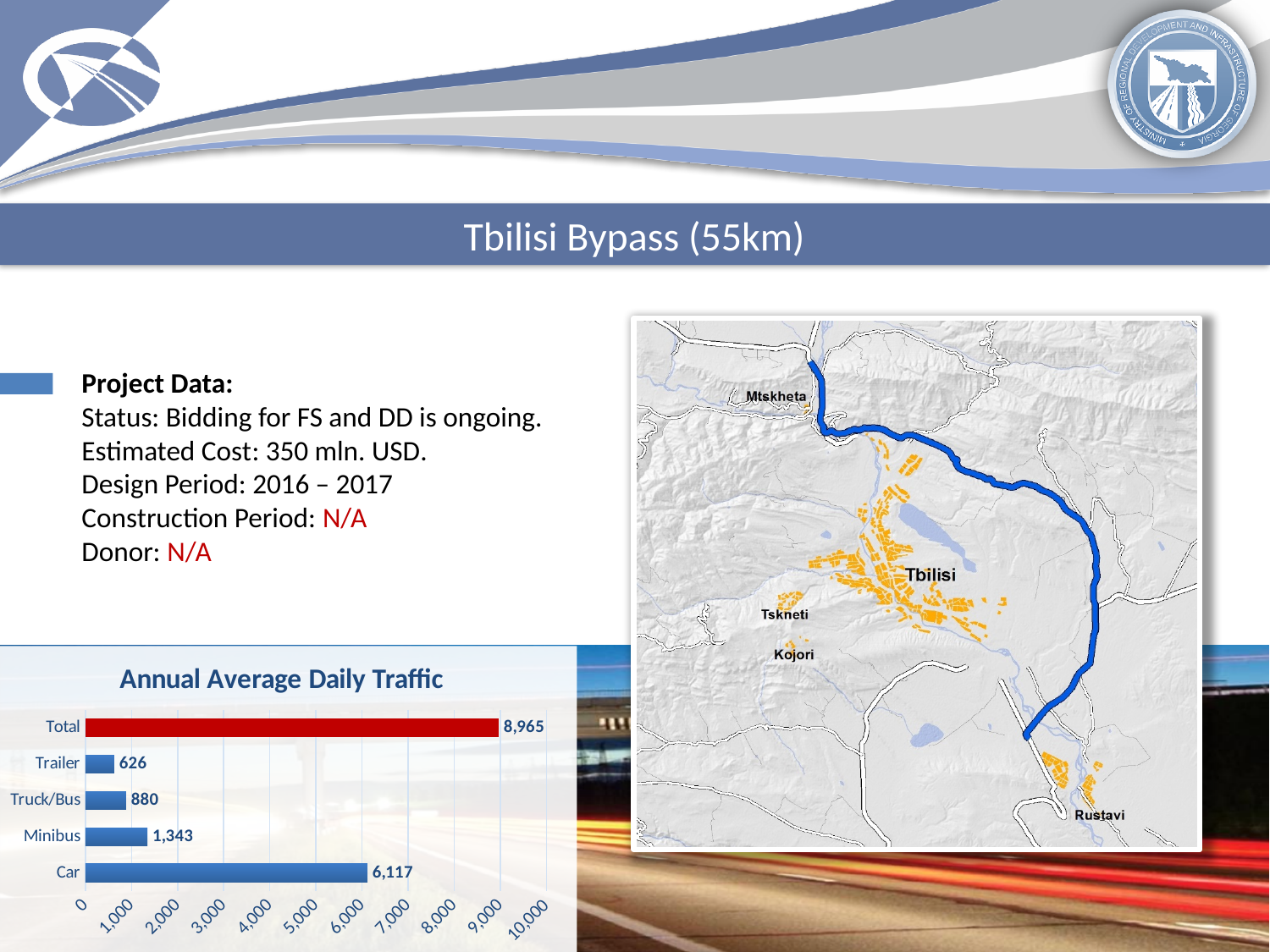
What kind of chart is the Annual Average Daily Traffic chart? bar chart What is the value for Trailer in the Annual Average Daily Traffic chart? 626 Which category has the lowest value in the Annual Average Daily Traffic chart? Trailer How many categories are shown in the Annual Average Daily Traffic chart? 5 Is the value for Car in the Annual Average Daily Traffic chart greater or less than 5,000? greater Which is larger in the Annual Average Daily Traffic chart, Truck/Bus or Trailer? Truck/Bus What is the difference between the Car and Minibus values in the Annual Average Daily Traffic chart? 4,774 What is the value for Car in the Annual Average Daily Traffic chart? 6,117 What is the value for Minibus in the Annual Average Daily Traffic chart? 1,343 Excluding Total, which category has the highest value in the Annual Average Daily Traffic chart? Car What is the Total value shown in the Annual Average Daily Traffic chart? 8,965 What is the value for Truck/Bus in the Annual Average Daily Traffic chart? 880